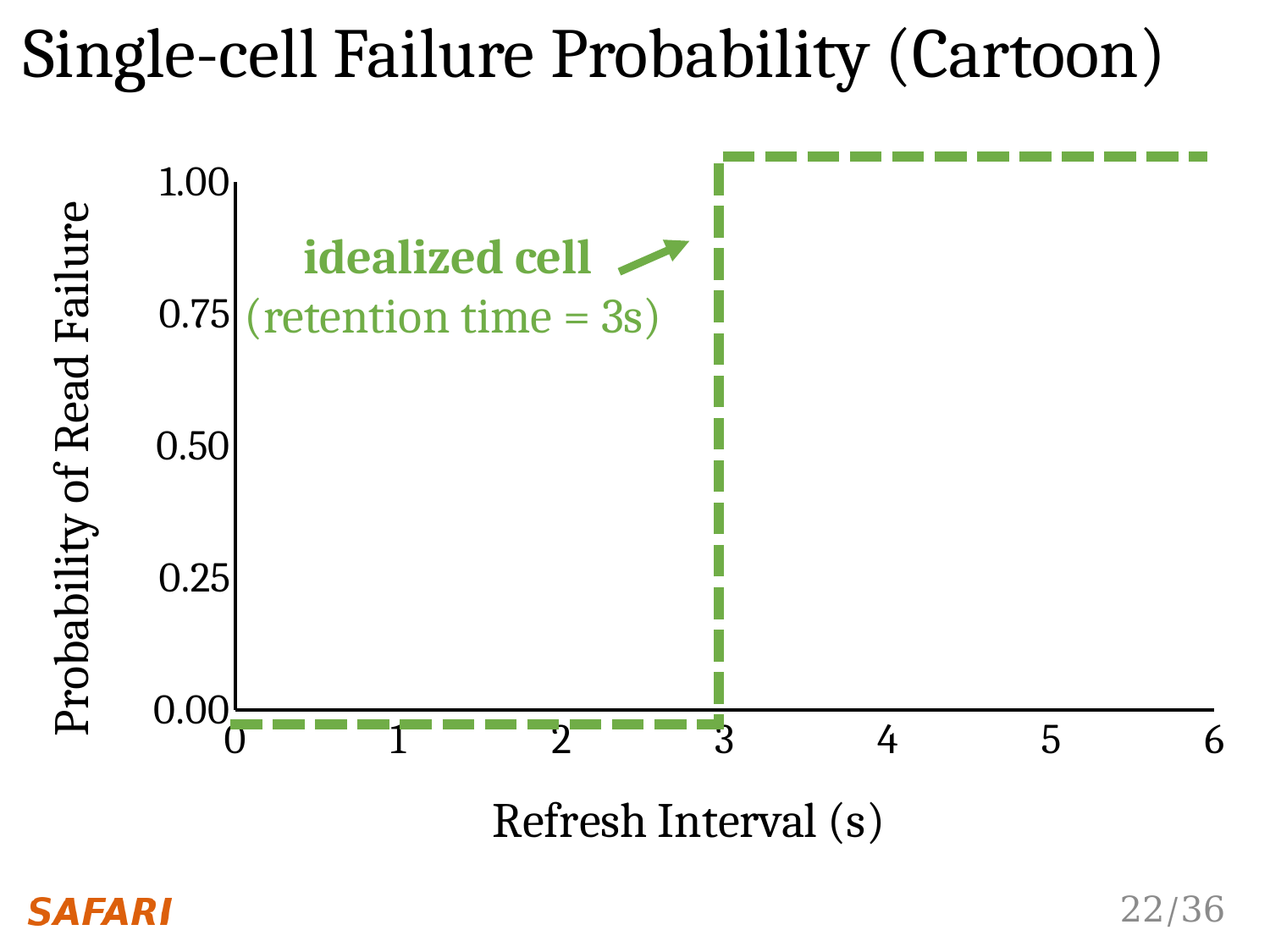
What is the title of the chart on the slide? Single-cell Failure Probability (Cartoon) What kind of chart is shown on the slide? line chart Is the probability of read failure at a refresh interval of 4 s greater or less than 0.50? greater Which is larger, the probability of read failure at 2 s or at 4 s? 4 s What is the difference between the probability of read failure at 5 s and at 1 s? 1.00 What is the probability of read failure at a refresh interval of 1 s? 0.00 At what refresh interval does the probability of read failure jump from 0.00 to 1.00? 3 Does the probability of read failure rise or fall as the refresh interval increases? rises Is the probability of read failure at a refresh interval of 2 s greater or less than 0.50? less What is the label of the x axis? Refresh Interval (s) What retention time is given for the idealized cell in the chart annotation? 3s What is the probability of read failure at a refresh interval of 5 s? 1.00